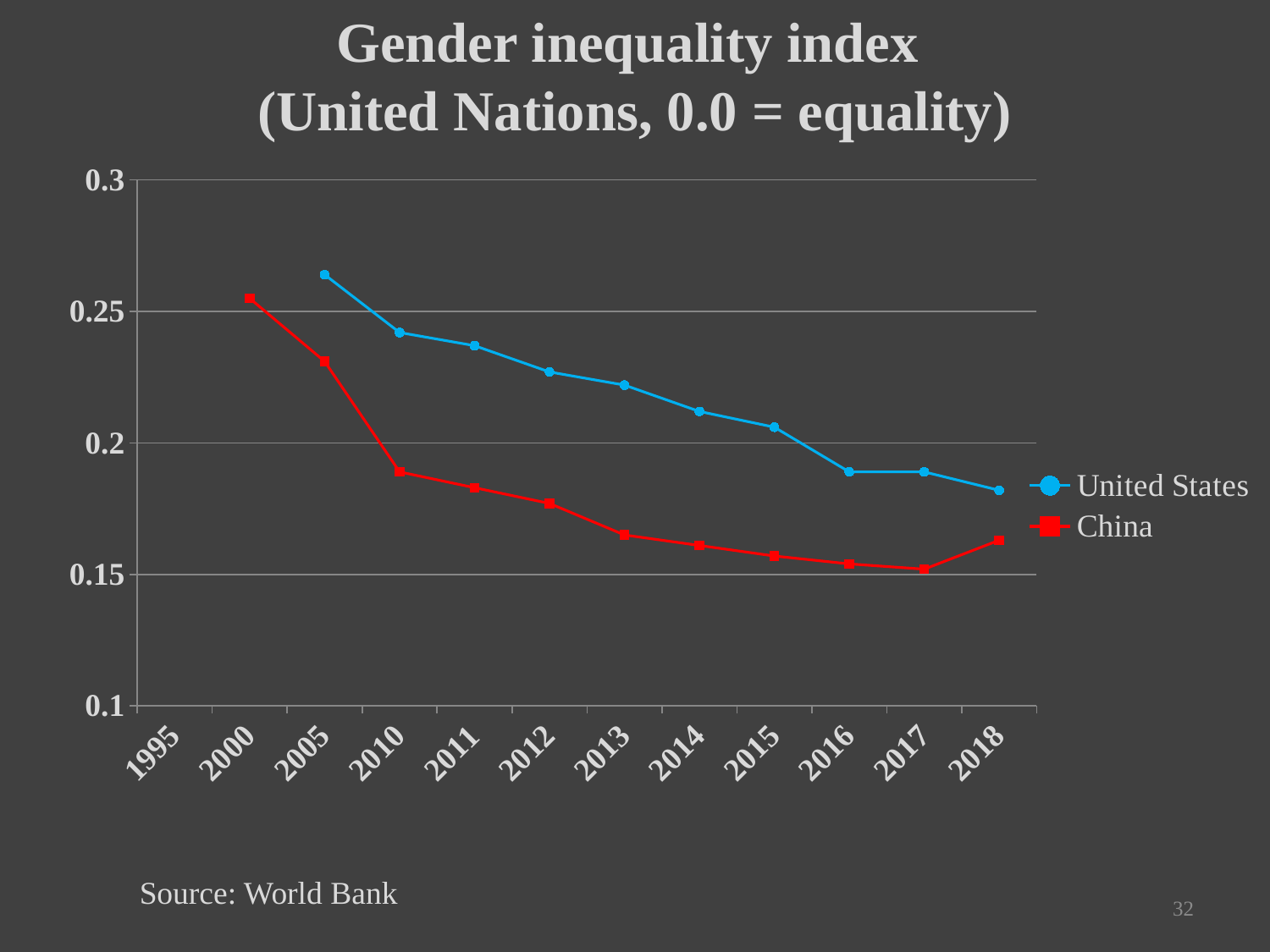
In which year does the United States series reach its highest value? 2005 Is the value for China in 2013 greater or less than 0.15? greater How many year labels are shown on the x axis? 12 In which year does the China series reach its highest value? 2000 Is the value for China in 2010 greater or less than 0.2? less Is the value for the United States in 2018 greater or less than 0.2? less How many series does the legend list? 2 Does the United States series rise or fall from 2005 to 2018? fall What type of chart is shown on the slide? line chart In 2015, which series has the higher value, United States or China? United States Which two series are shown in the legend? United States and China